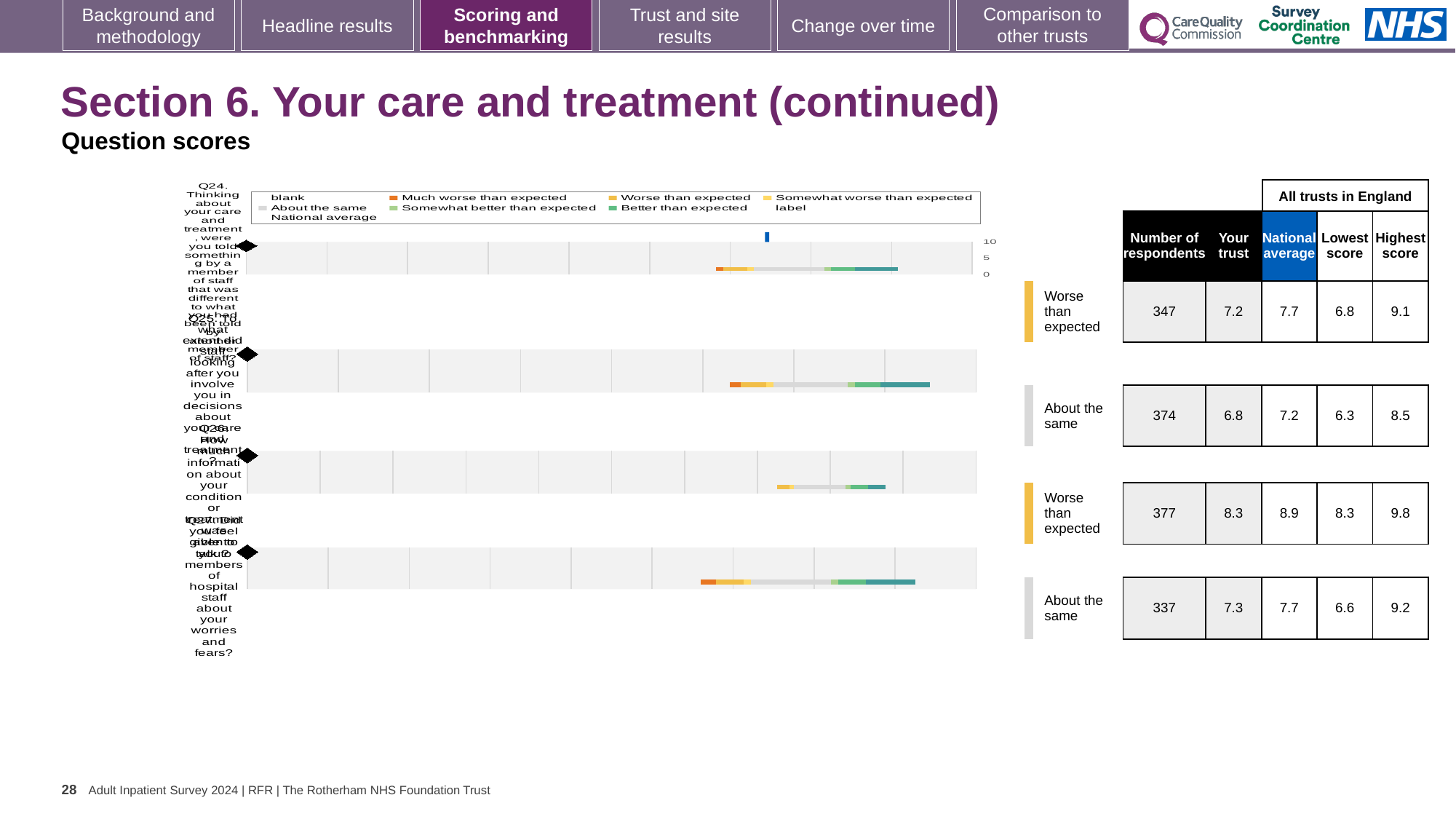
For the third chart (Q26), what is the national average score? 8.9 What kind of chart is used to show the question scores on this slide? bar chart For the second chart (Q25), what is the 'Your trust' score? 6.8 For the first chart (Q24), which is larger: the 'Your trust' score or the national average? National average What benchmark rating is shown next to the second chart (Q25)? About the same For the fourth chart (Q27), what is the highest score among all trusts in England? 9.2 For the third chart (Q26), what is the difference between the highest score and the lowest score? 1.5 How many question charts (Q24 to Q27) are shown on the slide? 4 What colour does the legend use for 'Much worse than expected'? Orange For the first chart (Q24), what is the number of respondents shown in the table? 347 Which question has the lowest number of respondents? Q27 Which question has the highest 'Your trust' score? Q26